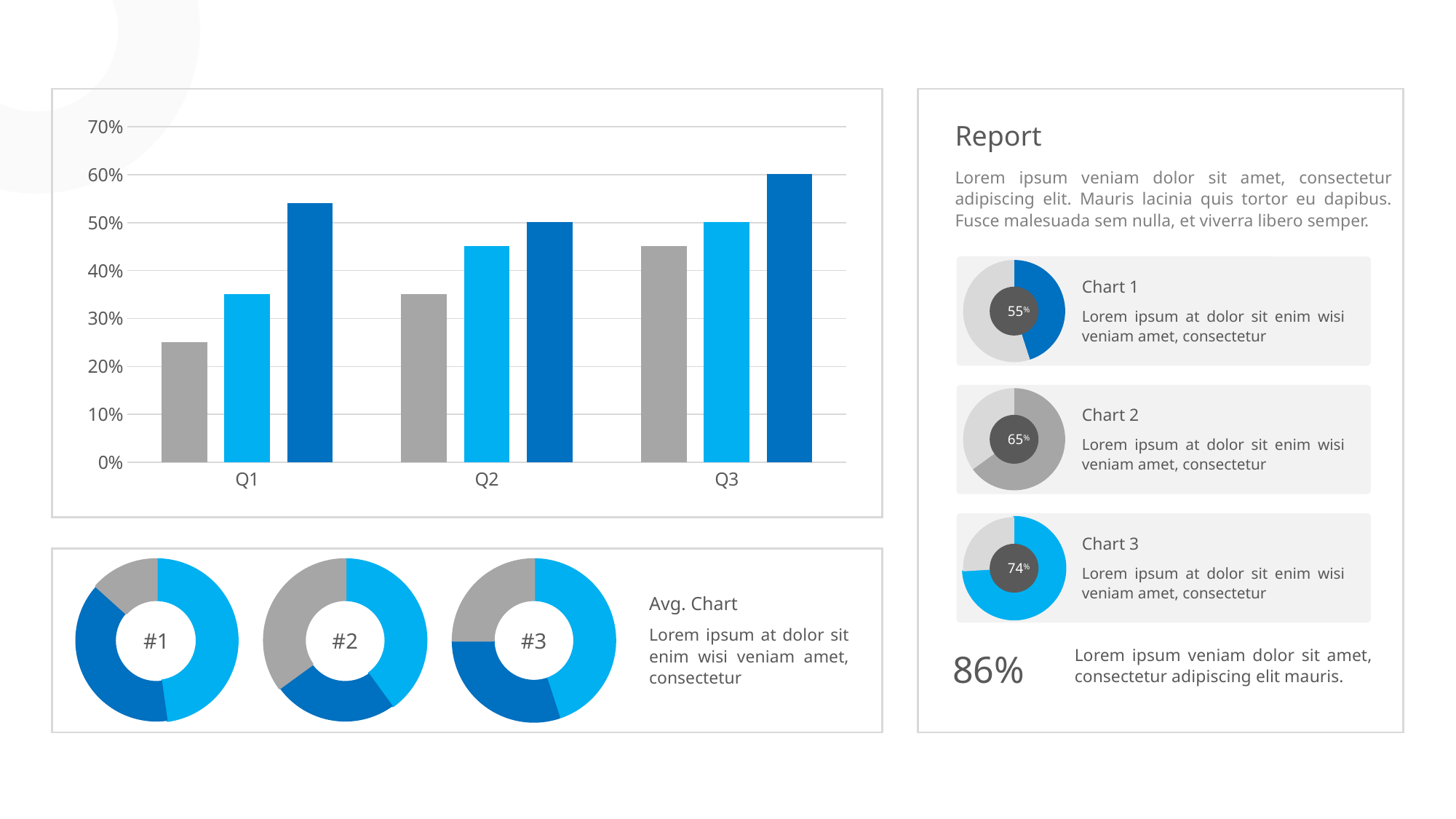
In the Report panel, what is the difference between the Chart 3 percentage and the Chart 1 percentage? 19% In the top-left bar chart, what value does the dark blue bar for Q2 reach? 50% In the top-left bar chart, what value does the dark blue bar for Q3 reach? 60% In the top-left bar chart, how many bars are there for each quarter? 3 In the Report panel, what percentage is shown in the centre of the Chart 1 donut? 55% In the Report panel, which of Chart 1, Chart 2 and Chart 3 shows the highest percentage? Chart 3 In the top-left bar chart, is the dark blue bar for Q1 greater or less than 50%? greater In the top-left bar chart, do the gray bars rise or fall from Q1 to Q3? rise In the top-left bar chart, which quarter has the tallest bar overall? Q3 What kind of chart is the top-left chart with Q1, Q2 and Q3? Bar chart In the top-left bar chart, how many categories are shown on the x axis? 3 In the top-left bar chart, is the gray bar for Q1 greater or less than 30%? less